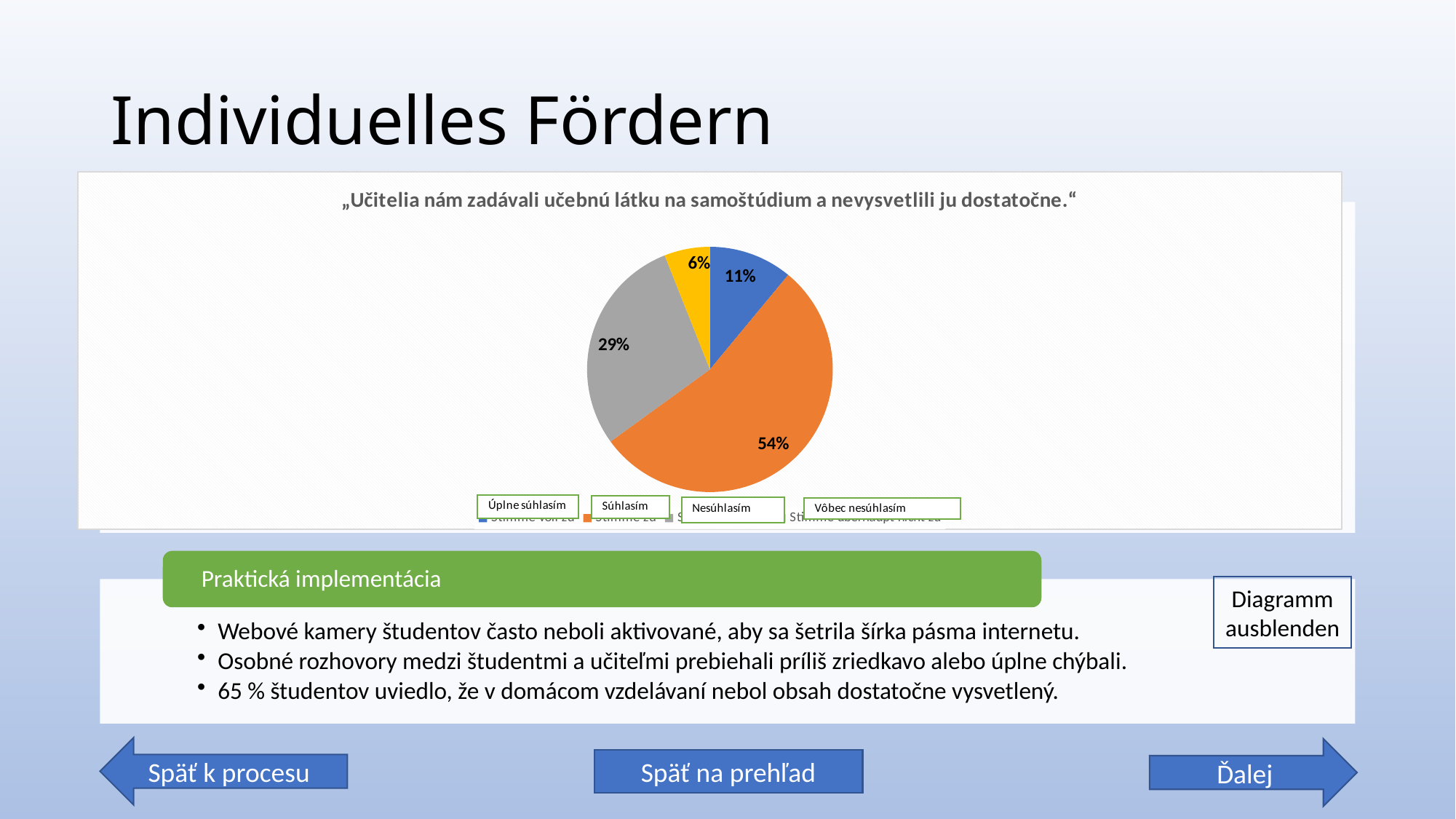
How many slices does the pie chart have? 4 What percentage is shown for the orange slice of the pie chart? 54% What statement is given as the title of the pie chart? „Učitelia nám zadávali učebnú látku na samoštúdium a nevysvetlili ju dostatočne.“ What is the combined percentage of the blue and orange slices? 65% What is the difference in percentage points between the orange slice and the grey slice? 25 percentage points Which slice of the pie chart is the smallest? the yellow slice (6%) What kind of chart is shown on the slide? pie chart Which slice of the pie chart is the largest? the orange slice (54%) What percentage is shown for the blue slice of the pie chart? 11% What percentage is shown for the yellow slice of the pie chart? 6% What percentage is shown for the grey slice of the pie chart? 29% Which is larger, the grey slice or the blue slice? the grey slice